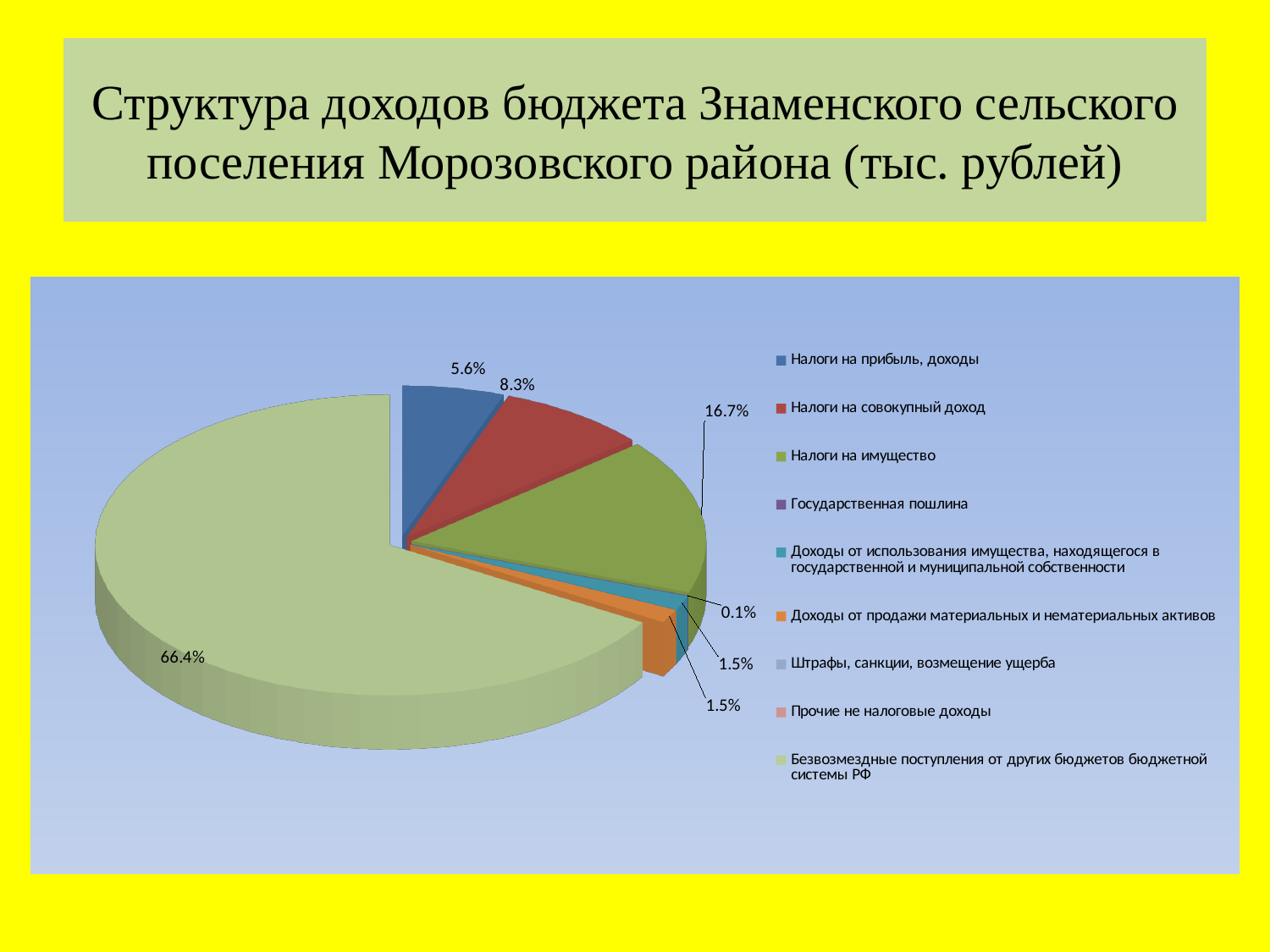
What share of the pie does "Налоги на прибыль, доходы" have? 5.6% What share of the pie does "Государственная пошлина" have? 0.1% What share of the pie does "Безвозмездные поступления от других бюджетов бюджетной системы РФ" have? 66.4% What share of the pie does "Налоги на совокупный доход" have? 8.3% Which is larger: the share for "Налоги на совокупный доход" or the share for "Налоги на прибыль, доходы"? Налоги на совокупный доход Which category has the largest slice of the pie? Безвозмездные поступления от других бюджетов бюджетной системы РФ What kind of chart is shown on the slide? Pie chart How many categories does the legend list? 9 What colour is the slice for "Налоги на прибыль, доходы"? Blue What share of the pie does "Налоги на имущество" have? 16.7% What is the difference in percentage points between "Налоги на имущество" and "Налоги на совокупный доход"? 8.4 Which labelled category has the smallest slice of the pie? Государственная пошлина